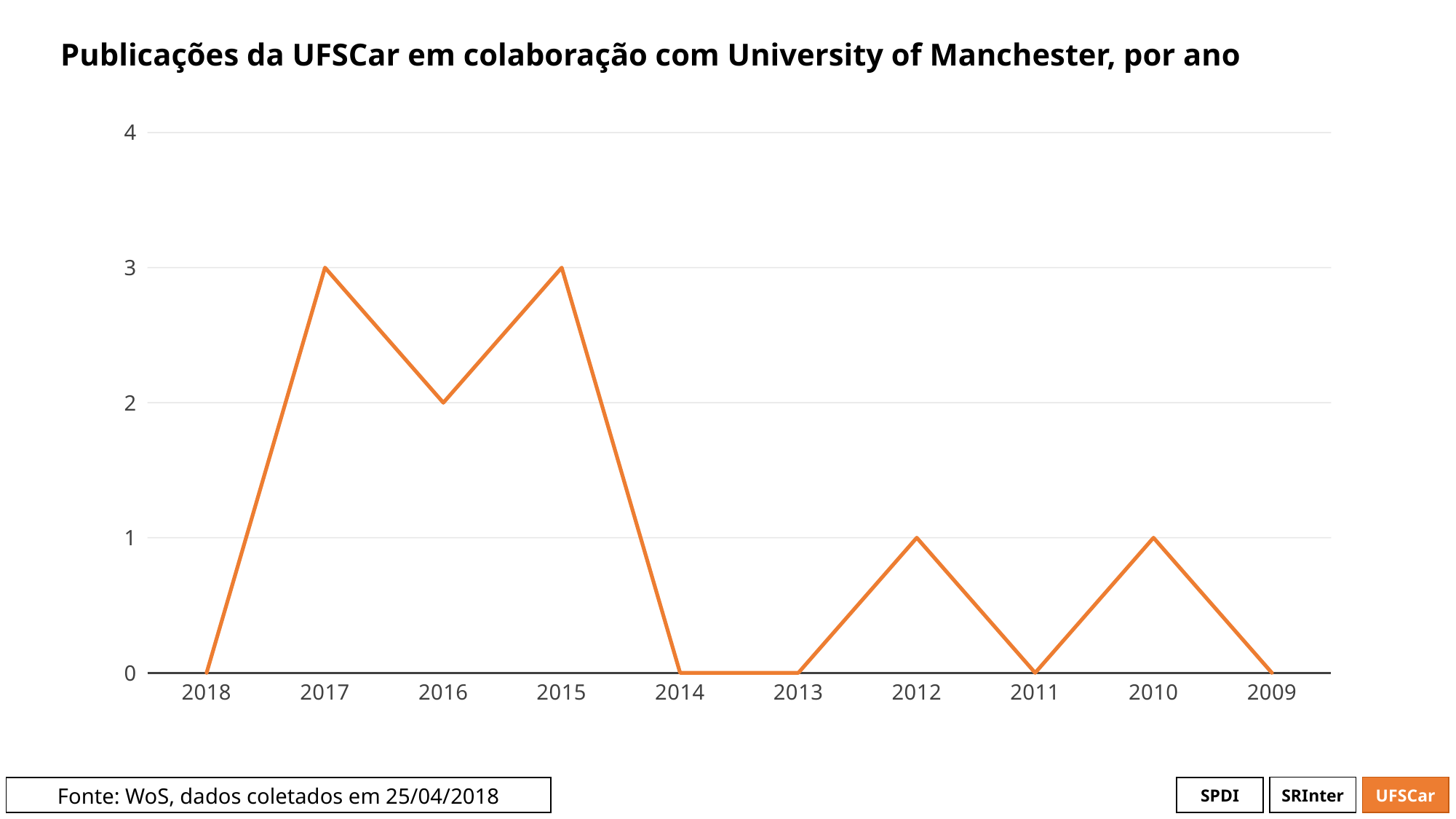
Which has a larger value, 2016 or 2010? 2016 What is the value for 2016? 2 What is the value for 2014? 0 Moving along the x axis from 2015 to 2014, does the value rise or fall? fall What is the difference between the values for 2017 and 2016? 1 What is the title of the chart? Publicações da UFSCar em colaboração com University of Manchester, por ano What is the difference between the values for 2015 and 2012? 2 How many years are plotted on the x axis? 10 What kind of chart is shown on the slide? line chart What is the highest value reached by the line? 3 What is the value for 2012? 1 What is the value for 2017? 3